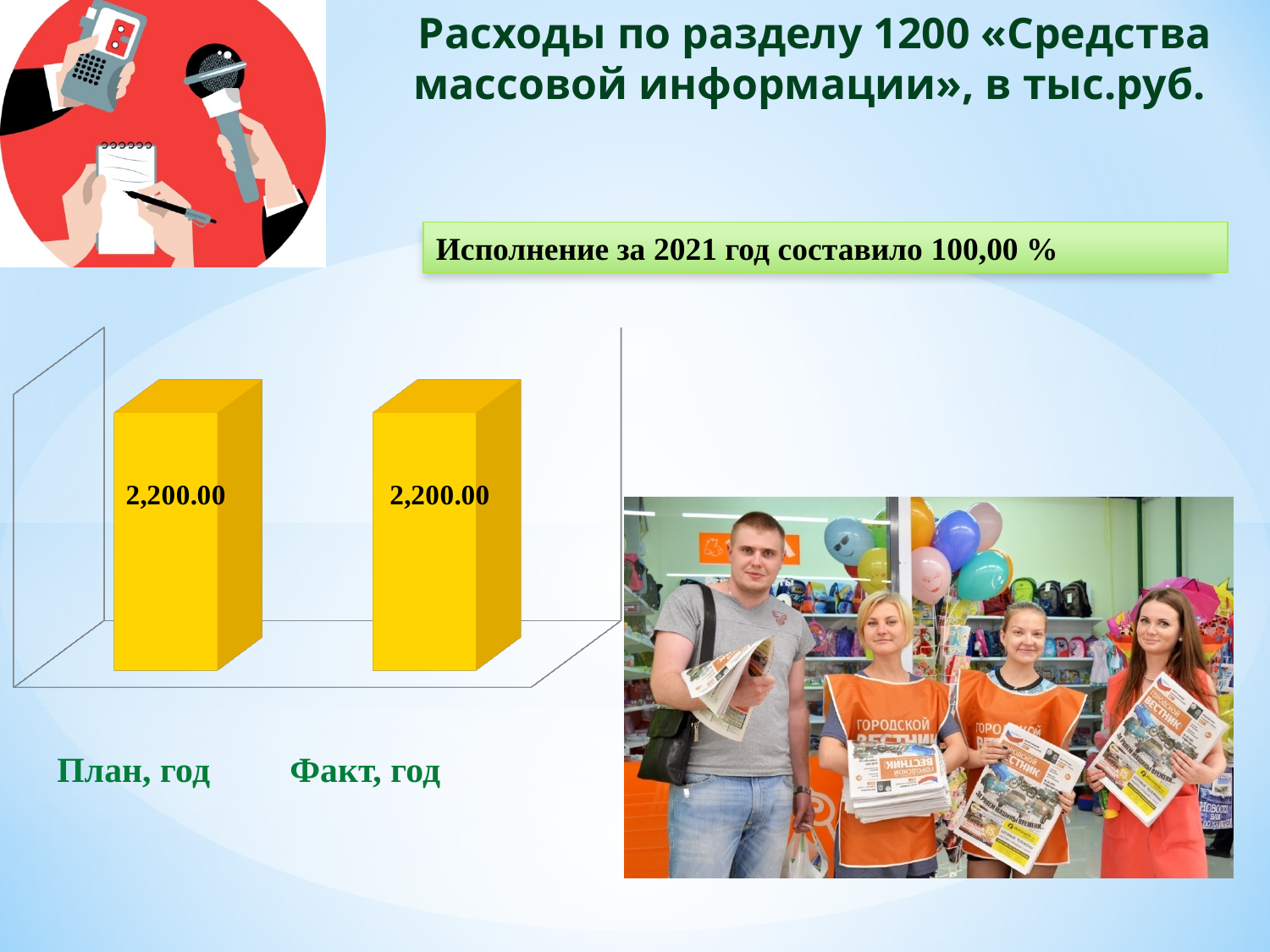
What is the value for «Факт, год»? 2,200.00 What is the title of the chart on the slide? Расходы по разделу 1200 «Средства массовой информации», в тыс.руб. What are the two category labels on the x axis? План, год; Факт, год How many bars are plotted in the chart? 2 What colour are the bars in the chart? yellow Are the values for «План, год» and «Факт, год» equal? yes What is the difference between the values for «План, год» and «Факт, год»? 0.00 What is the value for «План, год»? 2,200.00 What kind of chart is shown on the slide? bar chart